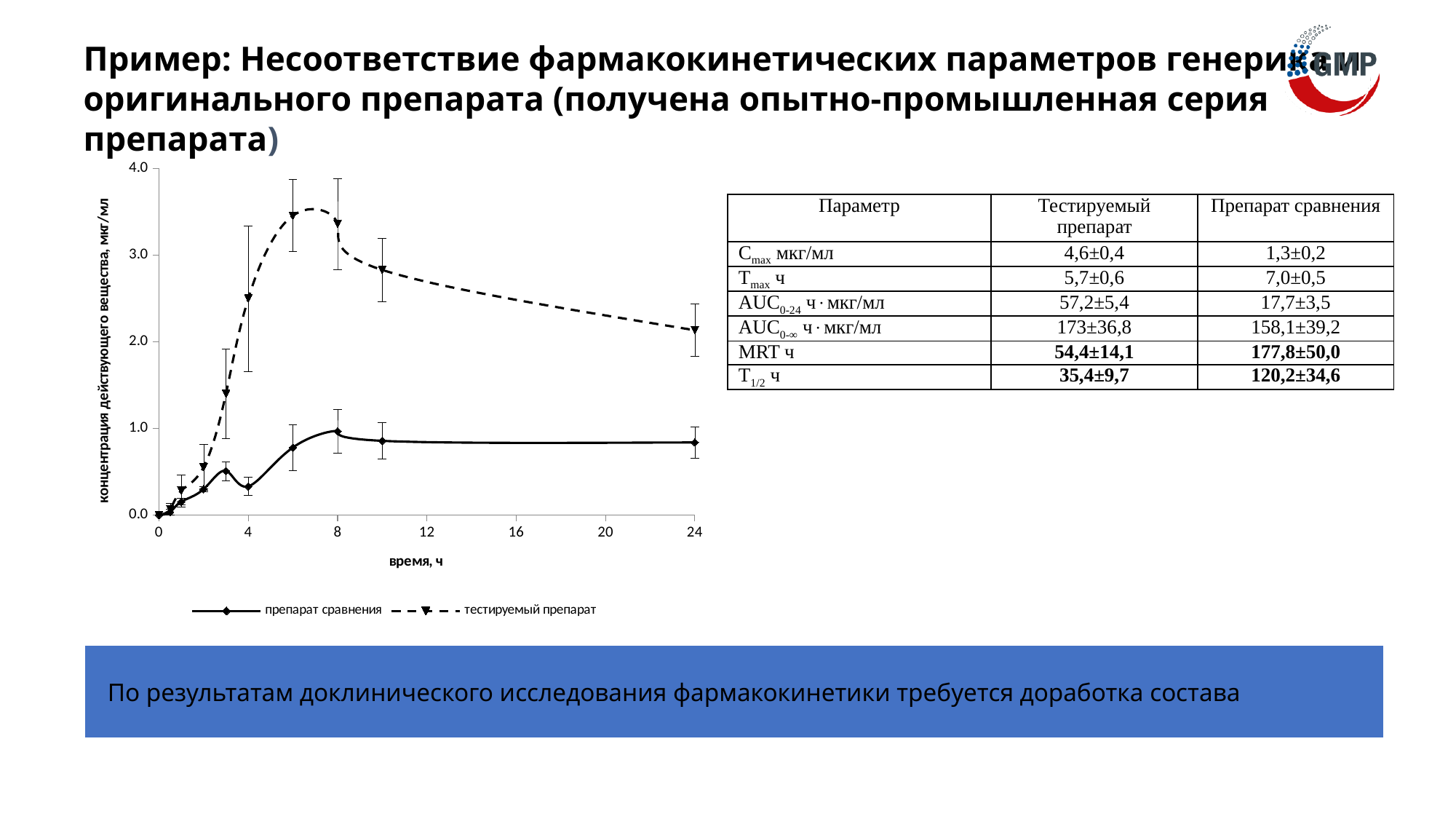
Does the concentration for тестируемый препарат rise or fall between 8 h and 24 h? fall What is the title of the x axis of the chart? время, ч What are the two series named in the chart legend? препарат сравнения and тестируемый препарат Is the value for тестируемый препарат at 24 h greater or less than 3.0? less Is the value for тестируемый препарат at 6 h greater or less than 3.0? greater How many series does the chart legend list? 2 Is the value for тестируемый препарат at 4 h greater or less than 2.0? greater Which series reaches the higher peak concentration on the chart? тестируемый препарат At 10 h, which series has the higher concentration: препарат сравнения or тестируемый препарат? тестируемый препарат What kind of chart is shown on the slide? line chart